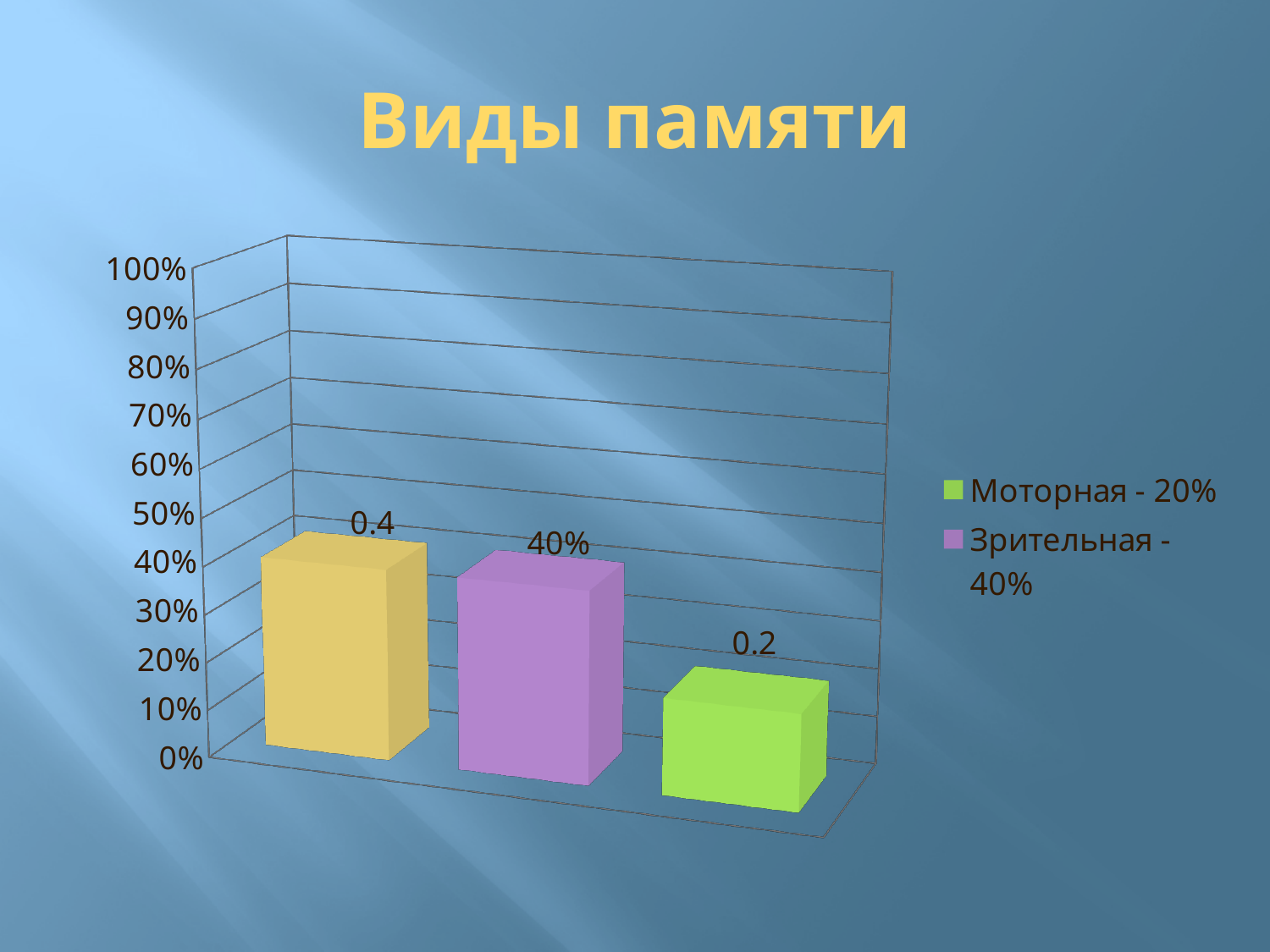
What value is shown for Зрительная in the chart? 40% Is the value for Моторная greater or less than 30%? less Which of the legend categories has the lowest bar? Моторная What data label is printed above the green bar (Моторная)? 0.2 Is the value for Зрительная greater or less than 30%? greater How many bars are plotted in the chart? 3 How many entries does the legend list? 2 What data label is printed above the yellow bar? 0.4 What kind of chart is shown on the slide? bar chart Which is larger, the value for Зрительная or the value for Моторная? Зрительная According to the legend, what colour represents Моторная? green What is the title of the slide? Виды памяти